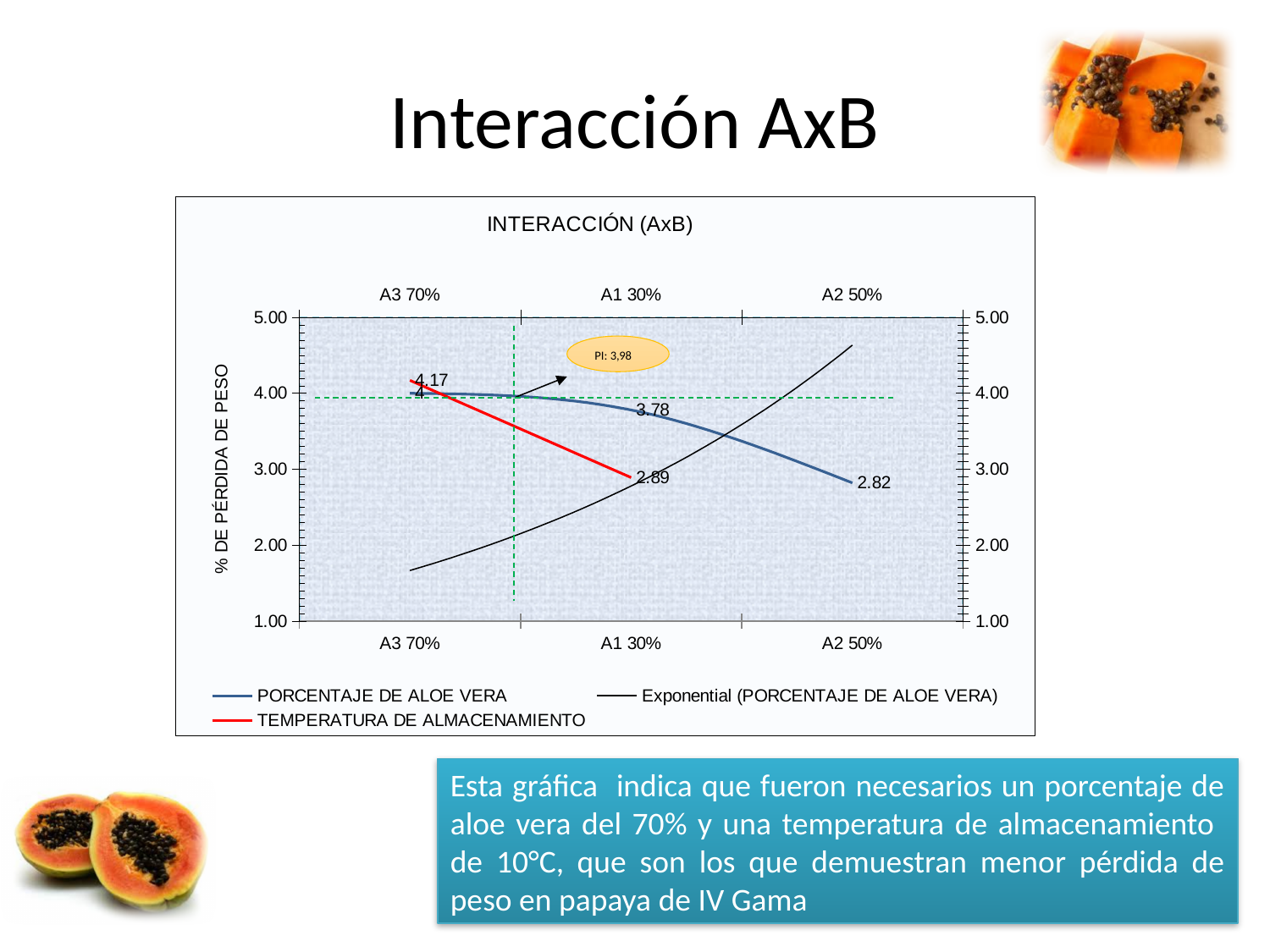
What is the difference between the PORCENTAJE DE ALOE VERA values at A3 70% and A2 50%? 1.18 At which category is PORCENTAJE DE ALOE VERA highest? A3 70% How many categories are shown on the x axis of the chart? 3 At which category is PORCENTAJE DE ALOE VERA lowest? A2 50% What kind of chart is shown on the slide? Line chart What is the value of TEMPERATURA DE ALMACENAMIENTO at A3 70%? 4.17 What is the value of TEMPERATURA DE ALMACENAMIENTO at A1 30%? 2.89 How many series does the chart legend list? 3 What is the title of the chart? INTERACCIÓN (AxB) Does the PORCENTAJE DE ALOE VERA series rise or fall from A3 70% to A2 50%? Fall What is the value of PORCENTAJE DE ALOE VERA at A1 30%? 3.78 What is the value of PORCENTAJE DE ALOE VERA at A2 50%? 2.82